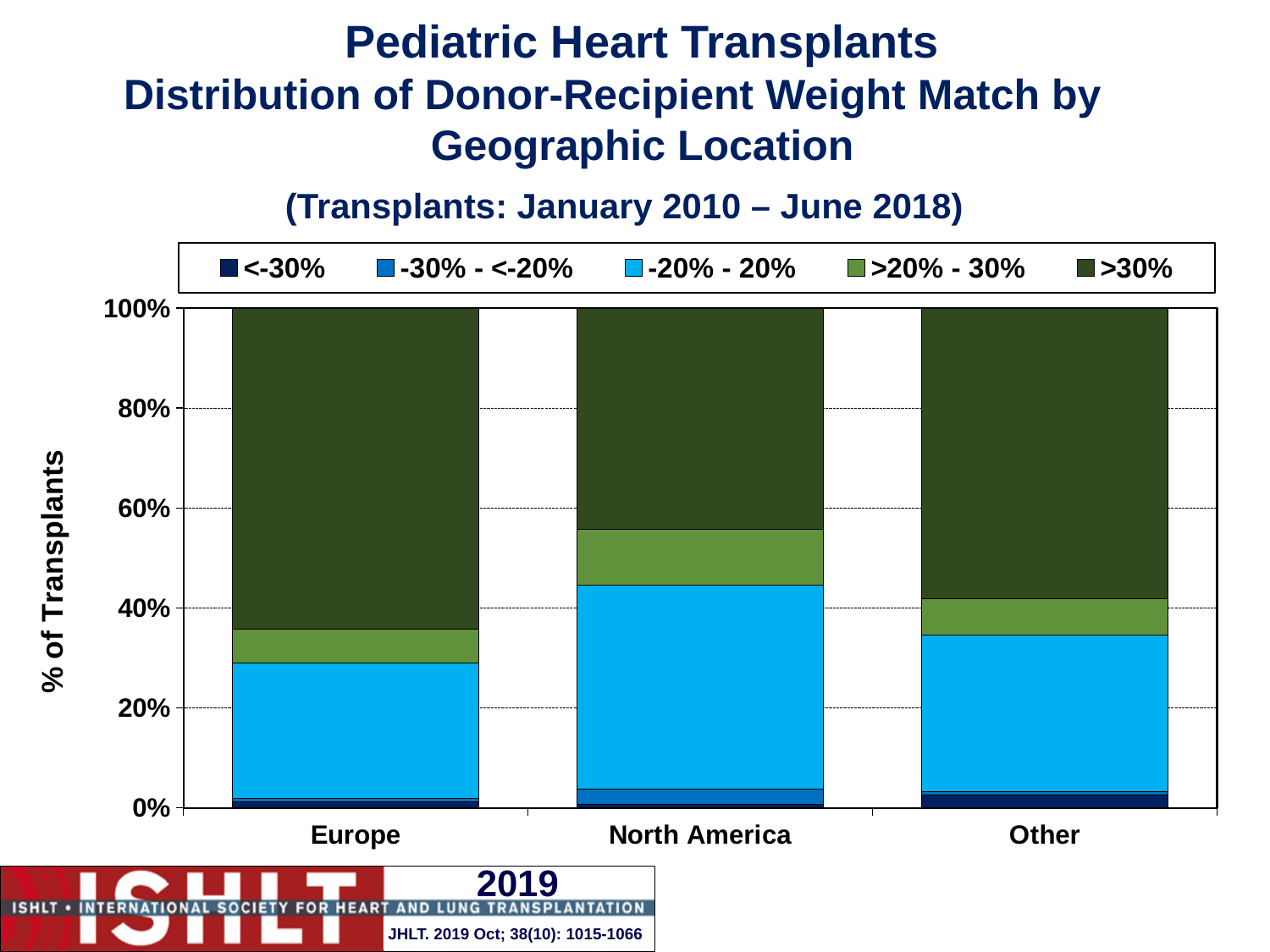
What kind of chart is shown on the slide? Stacked bar chart Which geographic location has the largest share of transplants in the -20% - 20% weight match category? North America Is the >30% share for Europe greater or less than 60%? greater How many series does the legend list? 5 What does each stacked bar total? 100% How many geographic locations are shown on the x axis? 3 What is the label of the y axis? % of Transplants Is the >30% share for North America greater or less than 50%? less Is the -20% - 20% share for North America larger or smaller than the -20% - 20% share for Europe? Larger What transplant period is stated in the chart title? January 2010 – June 2018 Is the >30% share for Europe larger or smaller than the >30% share for North America? Larger Which geographic location has the largest share of transplants in the >30% weight match category? Europe